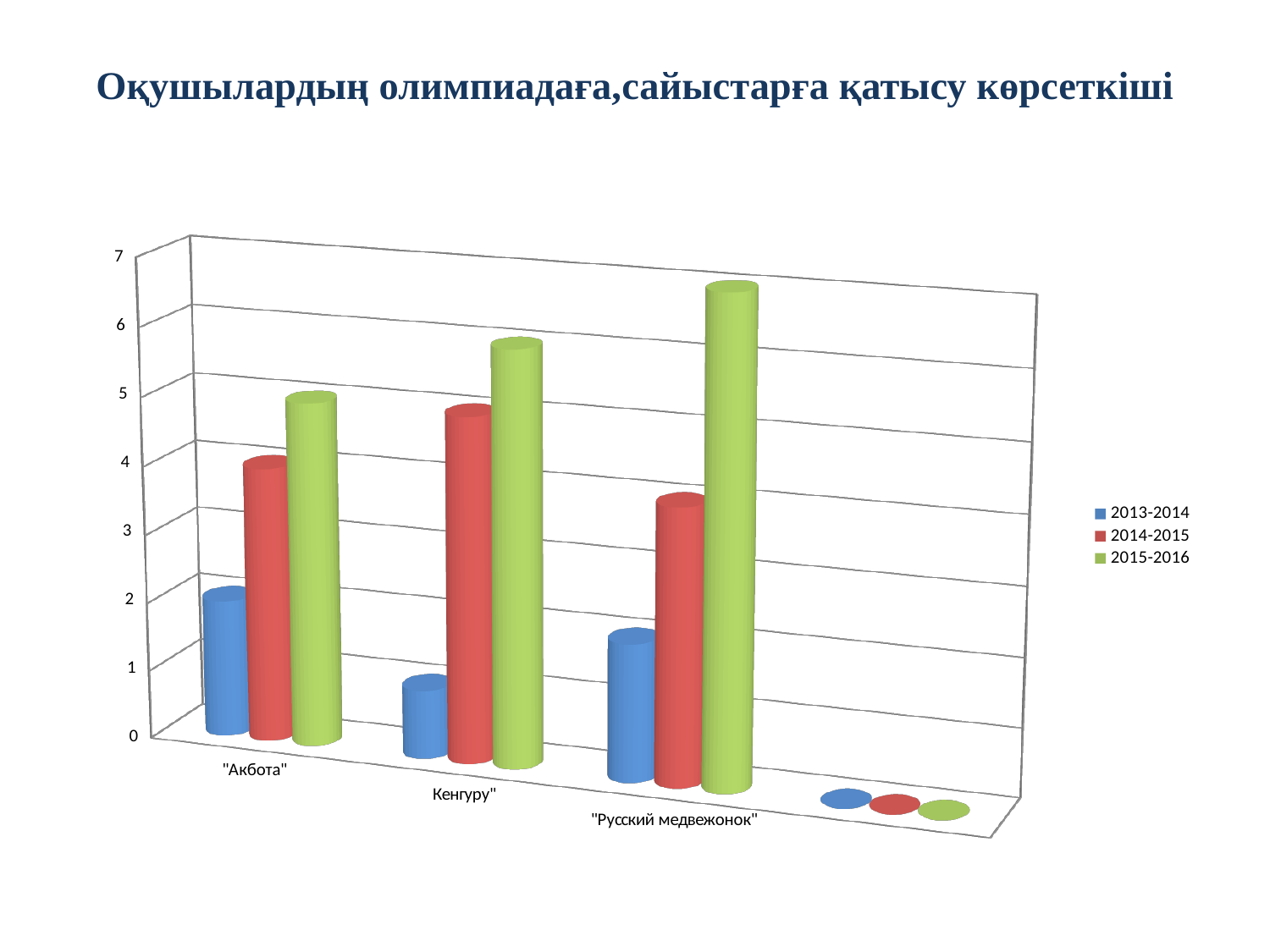
Is the 2015-2016 value for Кенгуру" greater or less than 4? greater Which colour represents the 2015-2016 series in the legend? Green How many series does the legend list? 3 Which category has the highest value for the 2015-2016 series? "Русский медвежонок" Which category has the highest value for the 2014-2015 series? Кенгуру" What kind of chart is shown on the slide? Bar chart Do the 2015-2016 values rise or fall from "Акбота" to "Русский медвежонок" along the x axis? rise Is the 2015-2016 value for "Русский медвежонок" greater or less than 5? greater Is the 2013-2014 value for Кенгуру" greater or less than 2? less For "Акбота", which is larger: the 2013-2014 value or the 2014-2015 value? 2014-2015 Which category has the lowest value for the 2013-2014 series? Кенгуру"